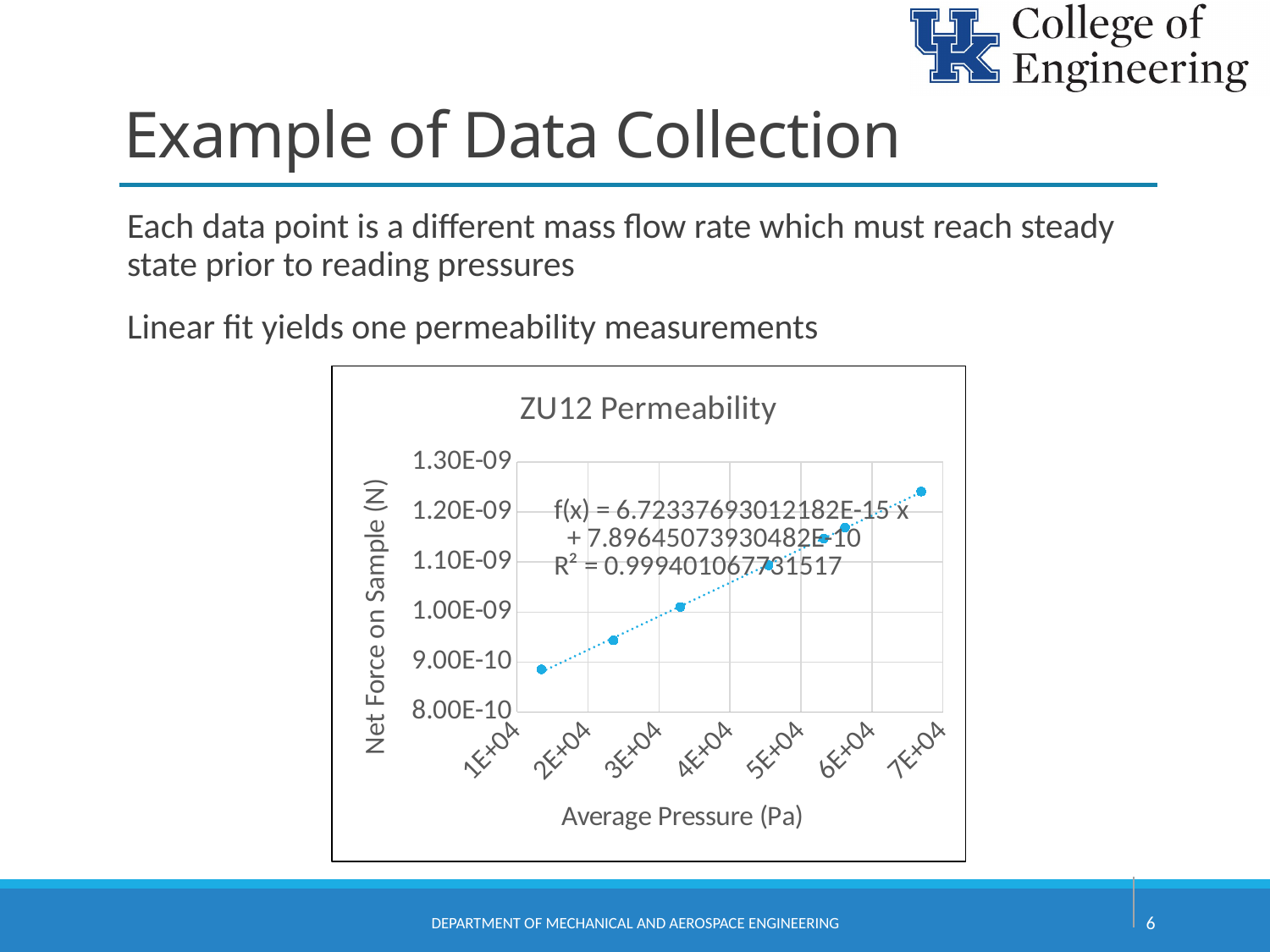
Do the values of Net Force on Sample rise or fall as Average Pressure increases? Rise Is the Net Force on Sample for the rightmost data point (near 7E+04 Pa) greater or less than 1.20E-09? greater What is the label of the x axis of the chart? Average Pressure (Pa) Is the Net Force on Sample for the data point near 2E+04 Pa greater or less than 9.00E-10? greater Which has a larger Net Force on Sample: the data point near 2E+04 Pa or the data point near 6E+04 Pa? The data point near 6E+04 Pa Which data point has the highest Net Force on Sample, the one at the lowest pressure or the one at the highest pressure? The one at the highest pressure How many data points are plotted in the chart? 7 Which data point has the lowest Net Force on Sample, the one near 1E+04 Pa or the one near 3E+04 Pa? The one near 1E+04 Pa What kind of chart is shown on the slide? Scatter chart What is the title of the chart? ZU12 Permeability Is the Net Force on Sample for the leftmost data point (near 1E+04 Pa) greater or less than 9.00E-10? less